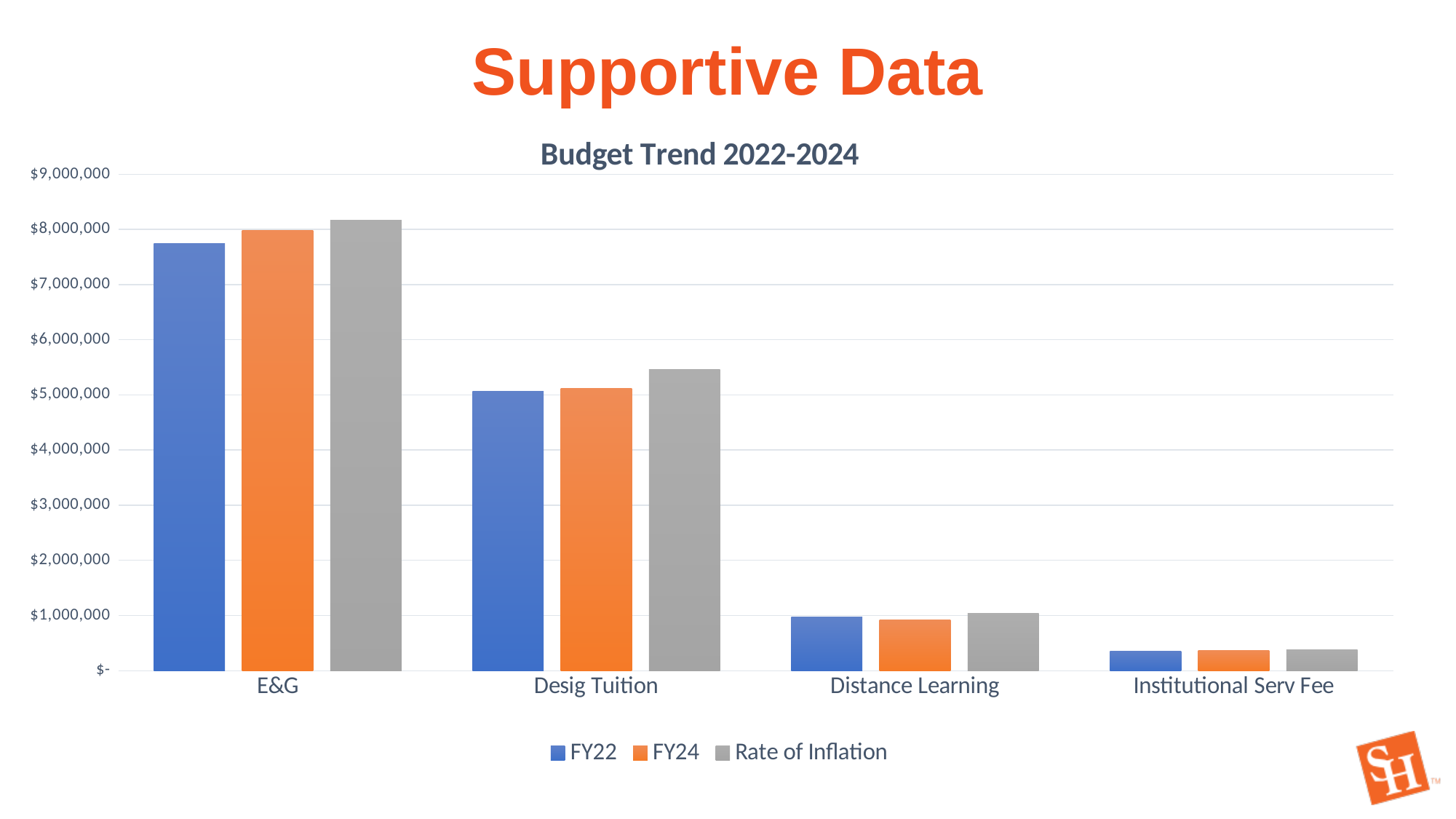
Which category has the lowest Rate of Inflation value? Institutional Serv Fee What is the title of the chart? Budget Trend 2022-2024 For E&G, which is larger: the FY22 value or the FY24 value? FY24 What type of chart is shown on the slide? Bar chart Which category has the highest FY22 value? E&G How many categories are shown on the x axis? 4 Is the FY22 value for E&G greater or less than $7,000,000? greater Is the Rate of Inflation value for Desig Tuition greater or less than $5,000,000? greater Is the FY24 value for Distance Learning greater or less than $1,000,000? less For Desig Tuition, which is larger: the FY24 value or the Rate of Inflation value? Rate of Inflation Do the FY22 values rise or fall moving from E&G to Institutional Serv Fee along the x axis? fall How many series does the legend list? 3